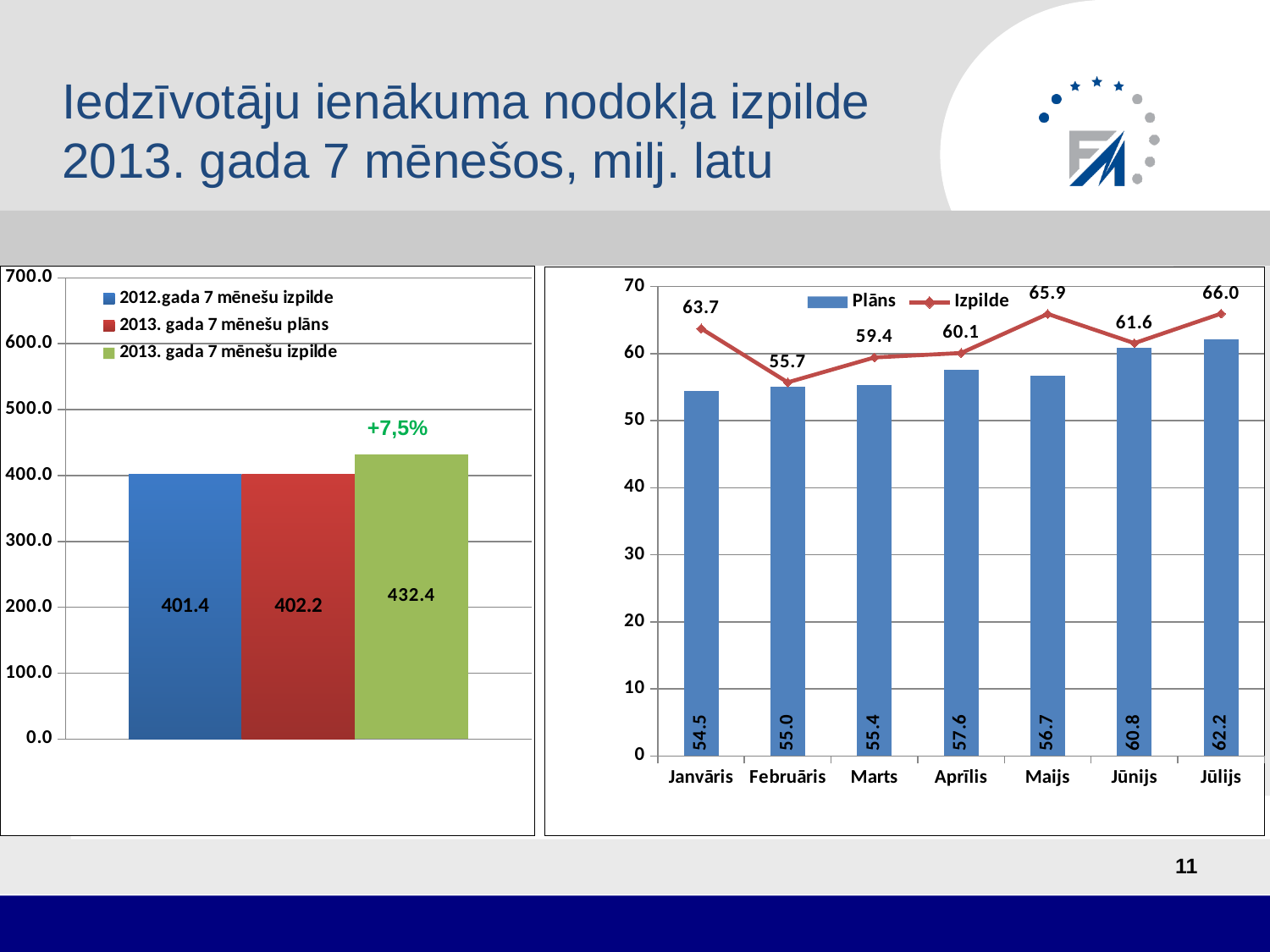
In the left chart, what is the difference between 2013. gada 7 mēnešu izpilde and 2013. gada 7 mēnešu plāns? 30.2 In the right chart, what is the Izpilde value for Maijs? 65.9 In the right chart, what is the difference between Izpilde and Plāns for Janvāris? 9.2 In the left chart, what is the value for 2013. gada 7 mēnešu izpilde? 432.4 In the left chart, how many series does the legend list? 3 In the right chart, is the Izpilde value for Jūlijs greater or less than the Plāns value for Jūlijs? greater In the right chart, which month has the highest Plāns value? Jūlijs In the left chart, what is the value for 2012.gada 7 mēnešu izpilde? 401.4 In the right chart, what is the Plāns value for Aprīlis? 57.6 In the right chart, which month has the lowest Izpilde value? Februāris In the left chart, what percentage change is annotated above the green bar? +7,5% In the right chart, how many months are shown on the x axis? 7